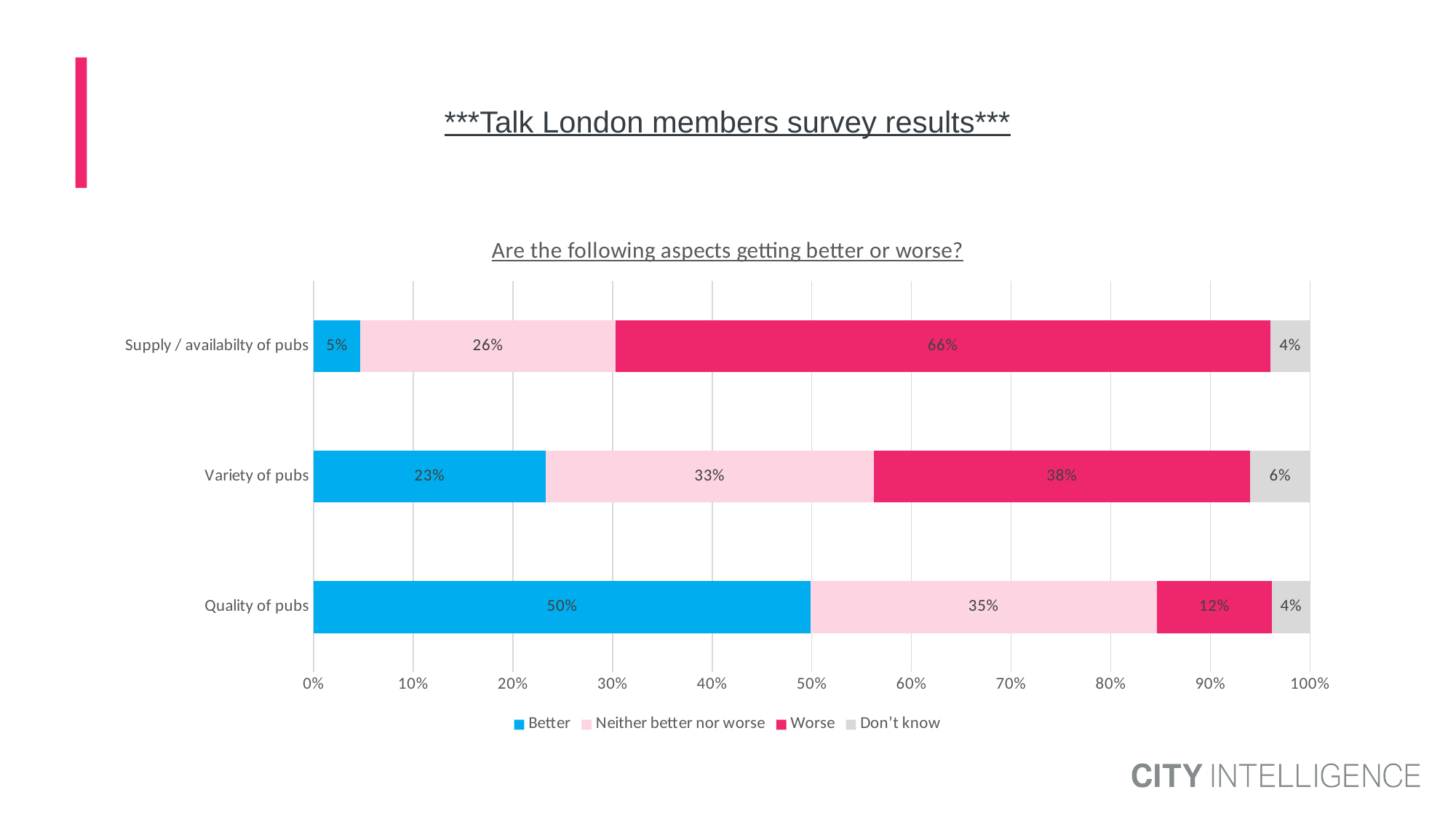
How many categories are shown on the chart? 3 What is the 'Neither better nor worse' value for Variety of pubs? 33% What is the difference between the 'Better' percentages for Quality of pubs and Variety of pubs? 27% How many series does the legend list? 4 What kind of chart is shown on the slide? Stacked bar chart What is the 'Don't know' value for Variety of pubs? 6% Which category has the lowest 'Better' percentage? Supply / availabilty of pubs Is the 'Worse' percentage larger for Variety of pubs or for Quality of pubs? Variety of pubs What percentage of respondents said the quality of pubs is getting better? 50% Which category has the highest 'Worse' percentage? Supply / availabilty of pubs What is the title of the chart? Are the following aspects getting better or worse? What percentage of respondents said the supply / availability of pubs is getting worse? 66%